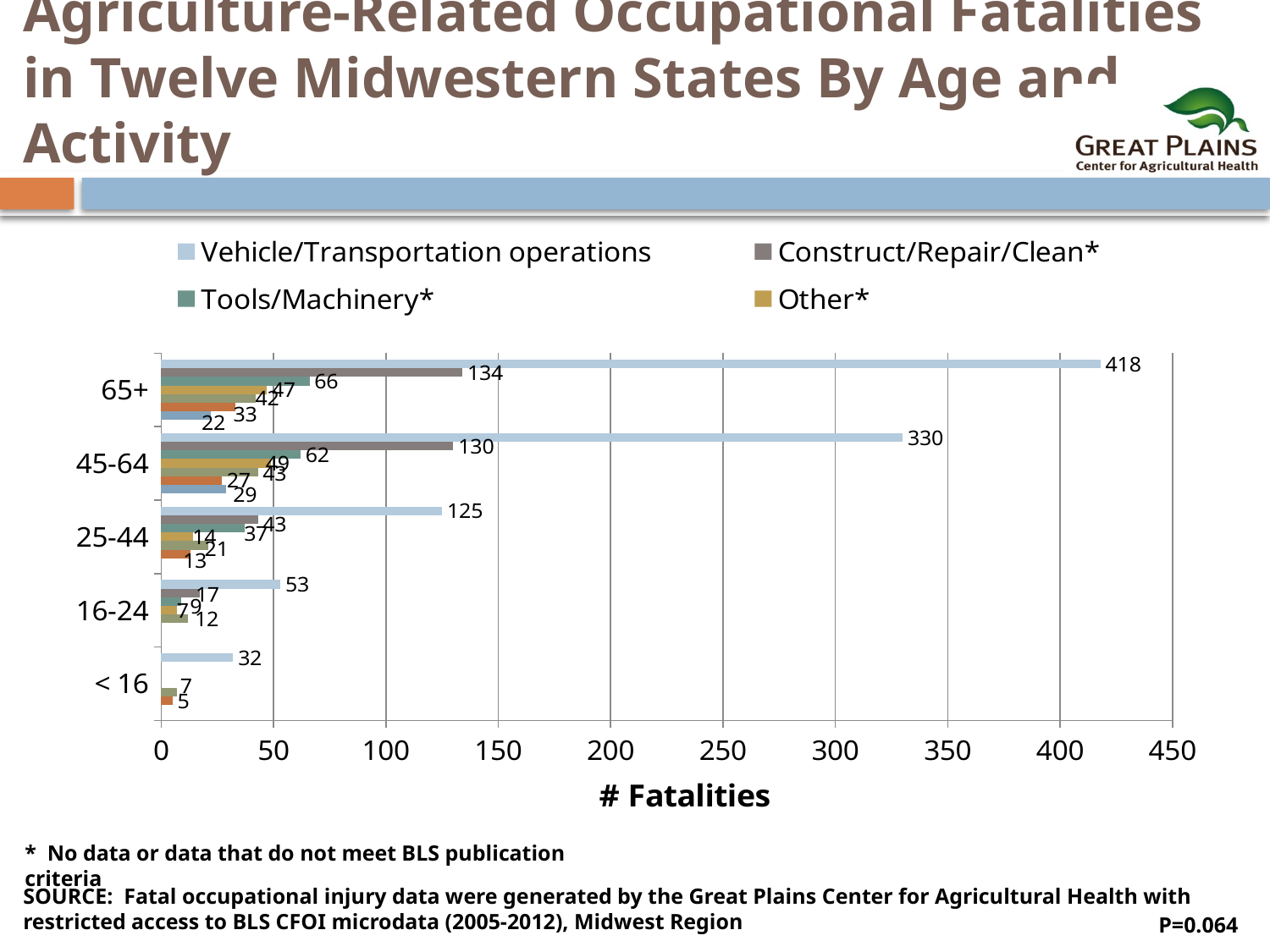
Which age group has the highest number of Vehicle/Transportation operations fatalities? 65+ What is the difference in Vehicle/Transportation operations fatalities between the 65+ and 45-64 age groups? 88 What is the number of fatalities for Construct/Repair/Clean in the 65+ age group? 134 What is the title of the horizontal axis? # Fatalities What is the number of fatalities for Vehicle/Transportation operations in the 45-64 age group? 330 Which is larger: Vehicle/Transportation operations fatalities for 25-44 or for 16-24? 25-44 How many age groups are shown on the chart? 5 Which age group has the lowest number of Vehicle/Transportation operations fatalities? < 16 What is the number of fatalities for Vehicle/Transportation operations in the < 16 age group? 32 What kind of chart is shown on the slide? bar chart What is the number of fatalities for Vehicle/Transportation operations in the 65+ age group? 418 Is the value for Vehicle/Transportation operations in the 25-44 age group greater or less than 100? greater